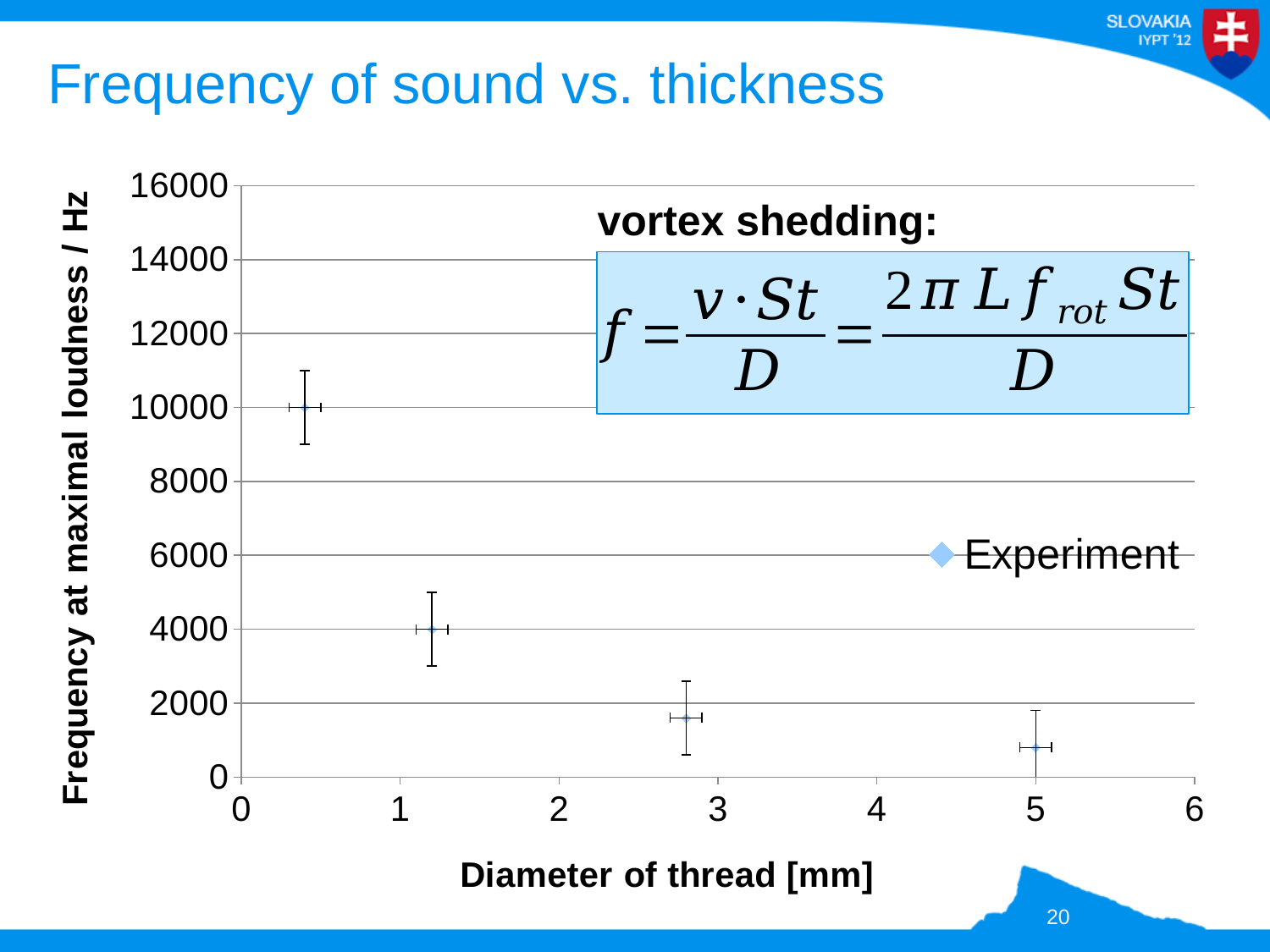
Is the frequency for the data point at a diameter of about 5 mm greater or less than 2000? less What is the name of the series shown in the legend? Experiment Which has the higher frequency: the leftmost data point or the rightmost data point? the leftmost data point How many series does the legend list? 1 What is the label of the vertical axis? Frequency at maximal loudness / Hz What kind of chart is shown on the slide? scatter chart Which data point has the highest frequency? the leftmost point (smallest diameter) What frequency does the leftmost data point (smallest diameter) land on? 10000 Is the frequency for the data point at a diameter of about 3 mm greater or less than 2000? less How many data points are plotted in the chart? 4 What frequency does the second data point from the left (diameter just above 1 mm) land on? 4000 Does the frequency rise or fall as the diameter of thread increases? fall